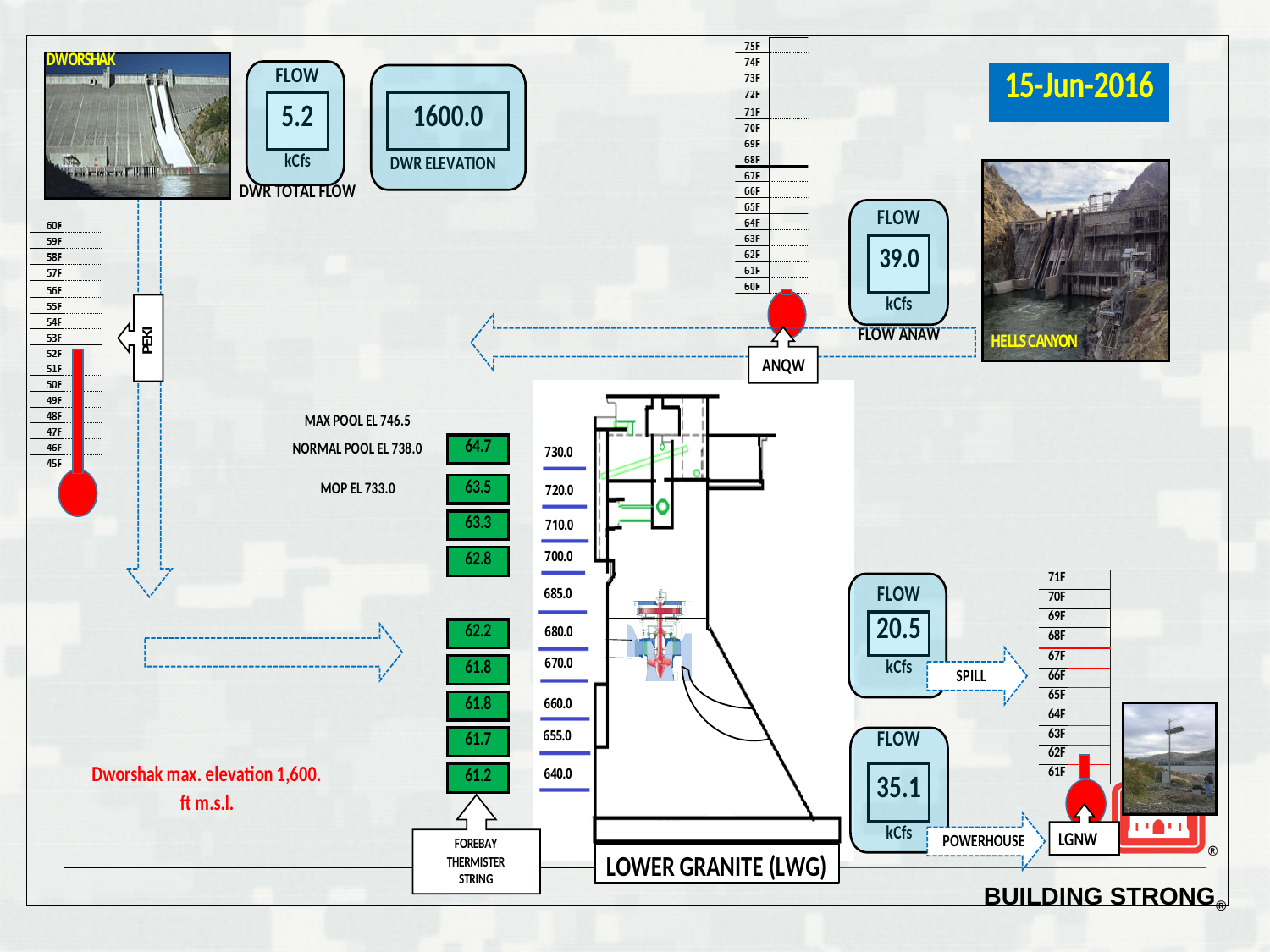
On the forebay thermistor string, which elevation has the highest reading? 730.0 On the forebay thermistor string, what is the difference between the reading at 730.0 and the reading at 640.0? 3.5 On the forebay thermistor string, do the readings rise or fall as elevation decreases from 730.0 to 640.0? fall How many readings are shown on the forebay thermistor string? 9 On the forebay thermistor string, what is the reading at elevation 700.0? 62.8 On the forebay thermistor string, which is larger: the reading at 720.0 or the reading at 700.0? 720.0 On the forebay thermistor string, which elevation has the lowest reading? 640.0 What is the label of the dam diagram in the centre of the slide? LOWER GRANITE (LWG) On the forebay thermistor string, what is the reading at elevation 640.0? 61.2 What is the date shown on the slide? 15-Jun-2016 On the forebay thermistor string, what is the reading at elevation 730.0? 64.7